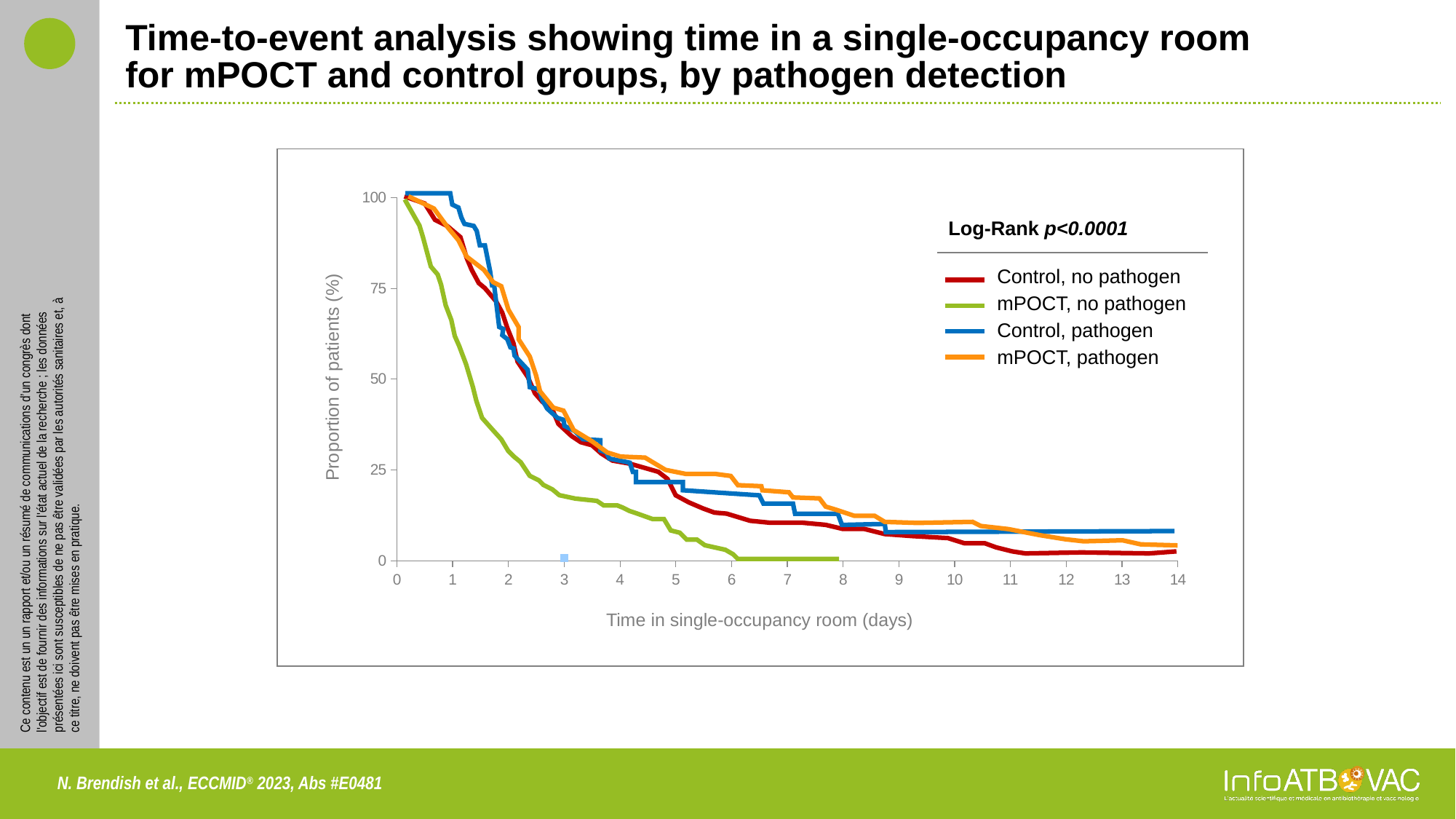
Is the value for Control, no pathogen at day 14 greater or less than 25? less How many series does the legend list? 4 Do the plotted proportions rise or fall as time in single-occupancy room increases? fall What are the four series named in the legend? Control, no pathogen; mPOCT, no pathogen; Control, pathogen; mPOCT, pathogen Is the value for mPOCT, no pathogen at day 2 greater or less than 50? less What kind of chart is shown on the slide? line chart Is the value for mPOCT, pathogen at day 8 greater or less than 25? less Which series has the highest proportion of patients at day 14? Control, pathogen Which series has the lowest proportion of patients at day 8? mPOCT, no pathogen What Log-Rank p value is printed on the chart? p<0.0001 At day 2, which is higher: Control, no pathogen or mPOCT, no pathogen? Control, no pathogen